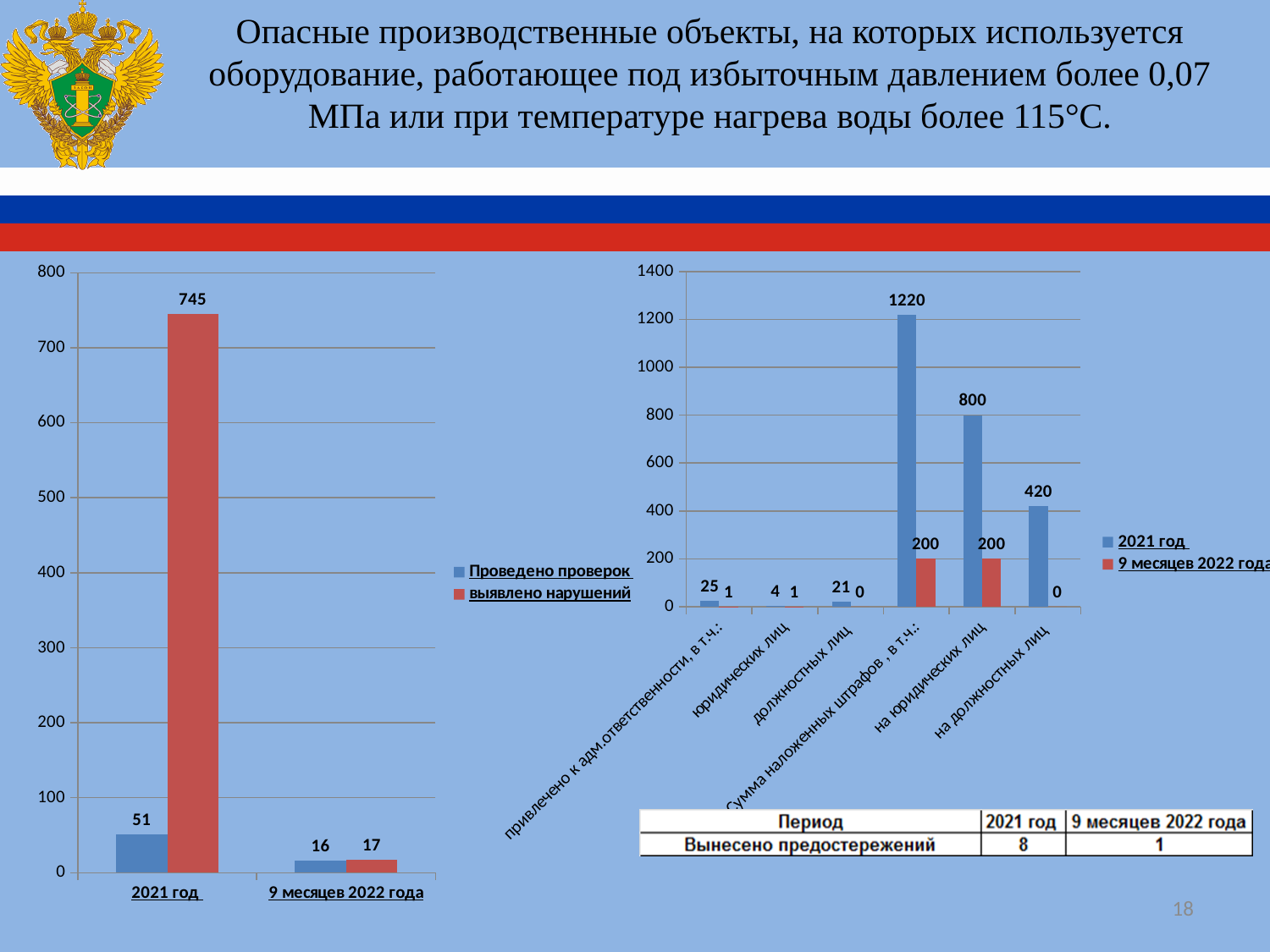
On the right chart, how many categories are shown on the x axis? 6 On the right chart, which category has the highest value for '2021 год'? Сумма наложенных штрафов, в т.ч.: On the left chart, which is larger for '9 месяцев 2022 года': 'Проведено проверок' or 'выявлено нарушений'? выявлено нарушений On the right chart, what is the value for 'Сумма наложенных штрафов, в т.ч.:' in '2021 год'? 1220 What kind of chart is the left chart? bar chart On the left chart, what is the value of 'выявлено нарушений' for '2021 год'? 745 On the left chart, how many series does the legend list? 2 On the right chart, what is the difference between the '2021 год' and '9 месяцев 2022 года' values for 'на юридических лиц'? 600 On the left chart, what is the difference between 'выявлено нарушений' and 'Проведено проверок' for '2021 год'? 694 On the left chart, what is the value of 'Проведено проверок' for '9 месяцев 2022 года'? 16 On the right chart, what is the value for 'на должностных лиц' in '9 месяцев 2022 года'? 0 On the right chart, what colour represents the '9 месяцев 2022 года' series? red